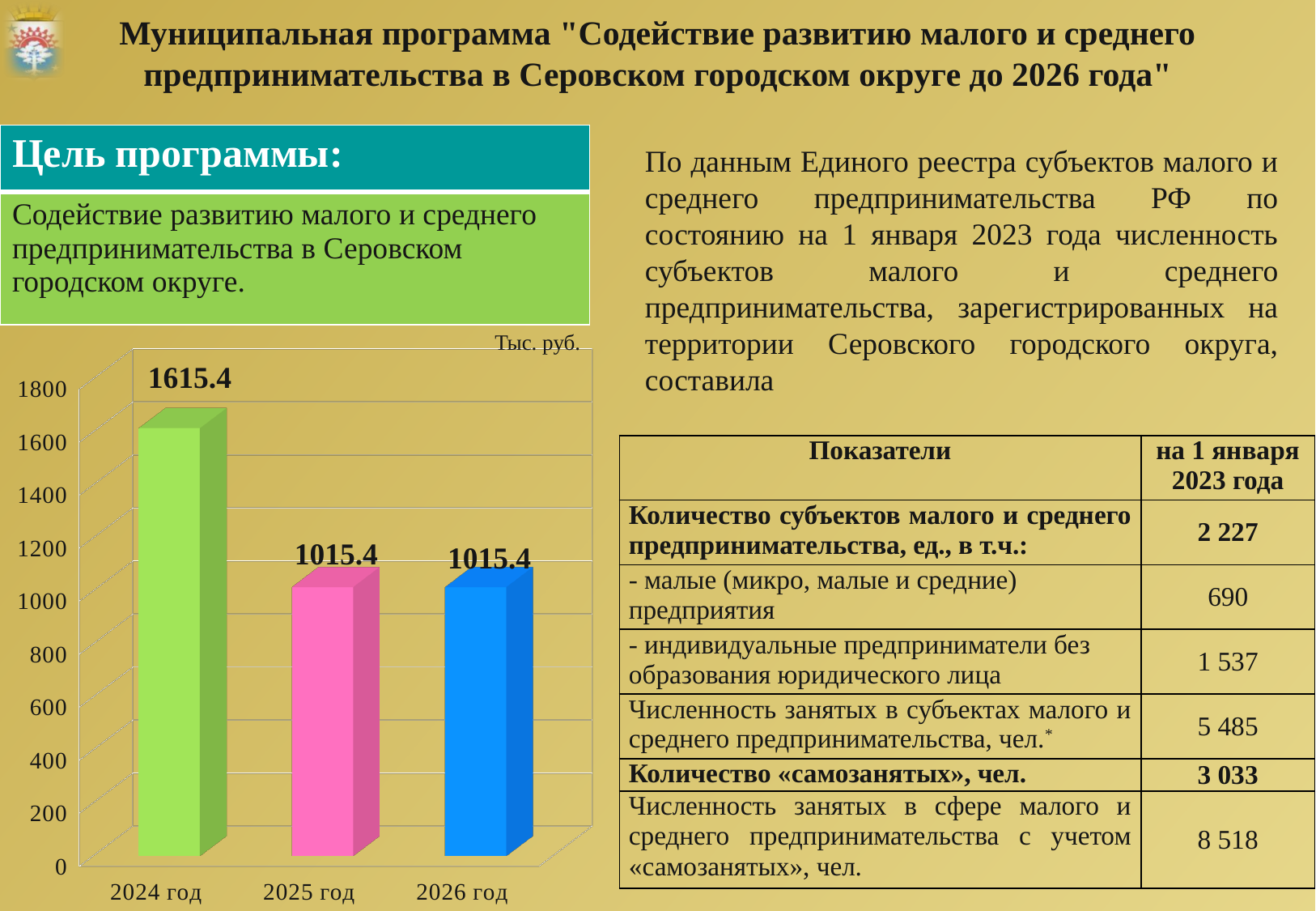
What is the value for 2024 год on the chart? 1615.4 Is the value for 2024 год greater or less than 1400? greater Which year has the highest value on the chart? 2024 год What kind of chart is shown on the slide? bar chart How many years (categories) are shown on the chart? 3 What unit is indicated above the chart? Тыс. руб. What is the value for 2026 год on the chart? 1015.4 Do the values rise or fall from 2024 год to 2025 год? fall What is the difference between the values for 2024 год and 2025 год? 600 What is the value for 2025 год on the chart? 1015.4 Is the value for 2025 год greater or less than 1200? less Which is larger, the value for 2024 год or the value for 2026 год? 2024 год